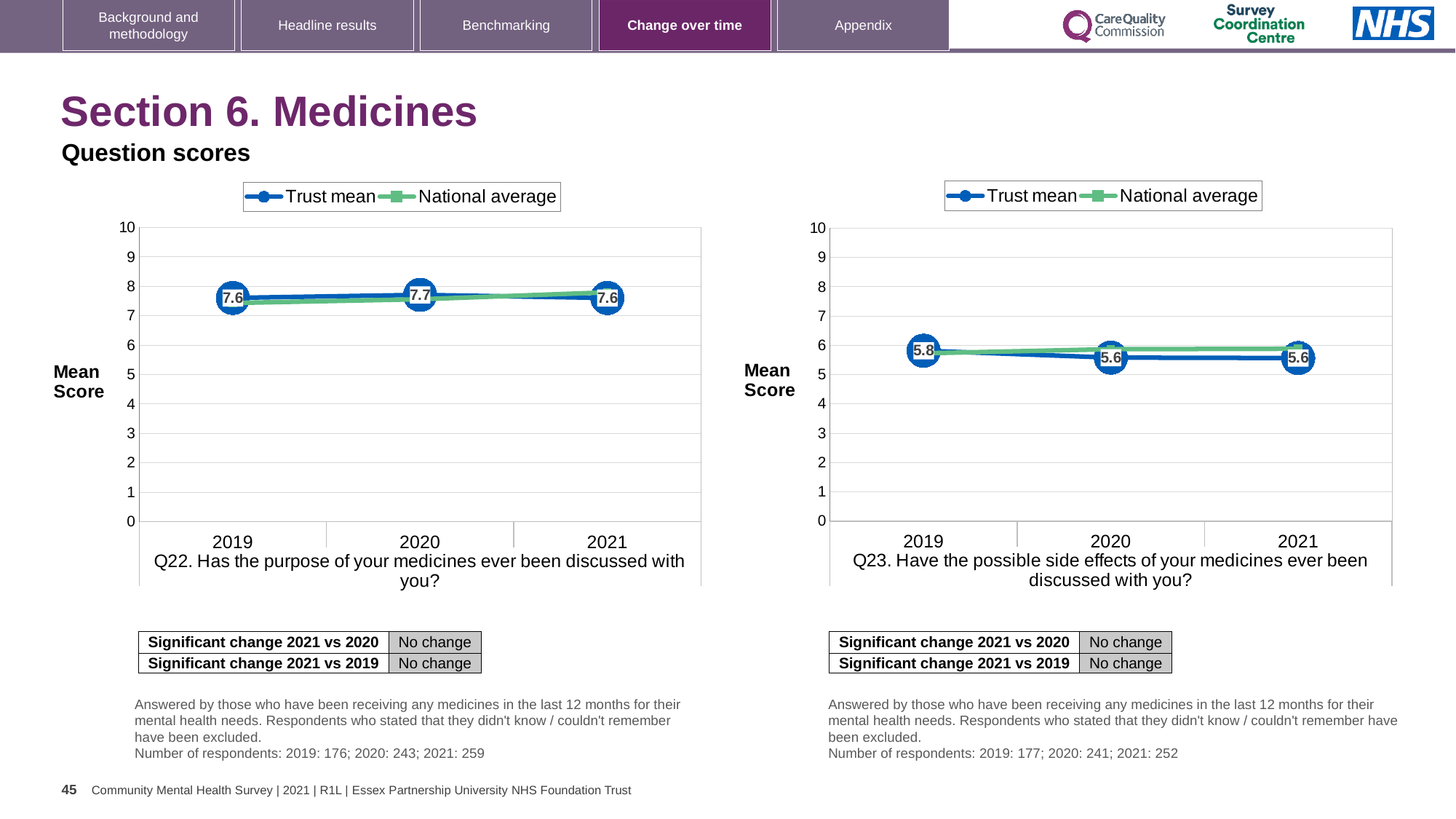
In the Q22 chart on the left, which year has the highest Trust mean score? 2020 In the Q23 chart on the right, what is the Trust mean score for 2021? 5.6 In the Q22 chart on the left, what is the Trust mean score for 2020? 7.7 In the Q22 chart on the left, what is the Trust mean score for 2019? 7.6 In the Q23 chart on the right, which year has the highest Trust mean score? 2019 In the Q22 chart on the left, is the National average value for 2021 greater or less than 7? greater In the Q23 chart on the right, what is the Trust mean score for 2019? 5.8 In the Q23 chart on the right, what is the difference between the Trust mean scores for 2019 and 2020? 0.2 How many series does the legend of the Q23 chart on the right list? 2 Is the Trust mean score for 2019 in the Q22 chart on the left larger or smaller than the Trust mean score for 2019 in the Q23 chart on the right? larger What kind of chart is the Q22 chart on the left? line chart In the Q22 chart on the left, what is the difference between the Trust mean scores for 2020 and 2021? 0.1